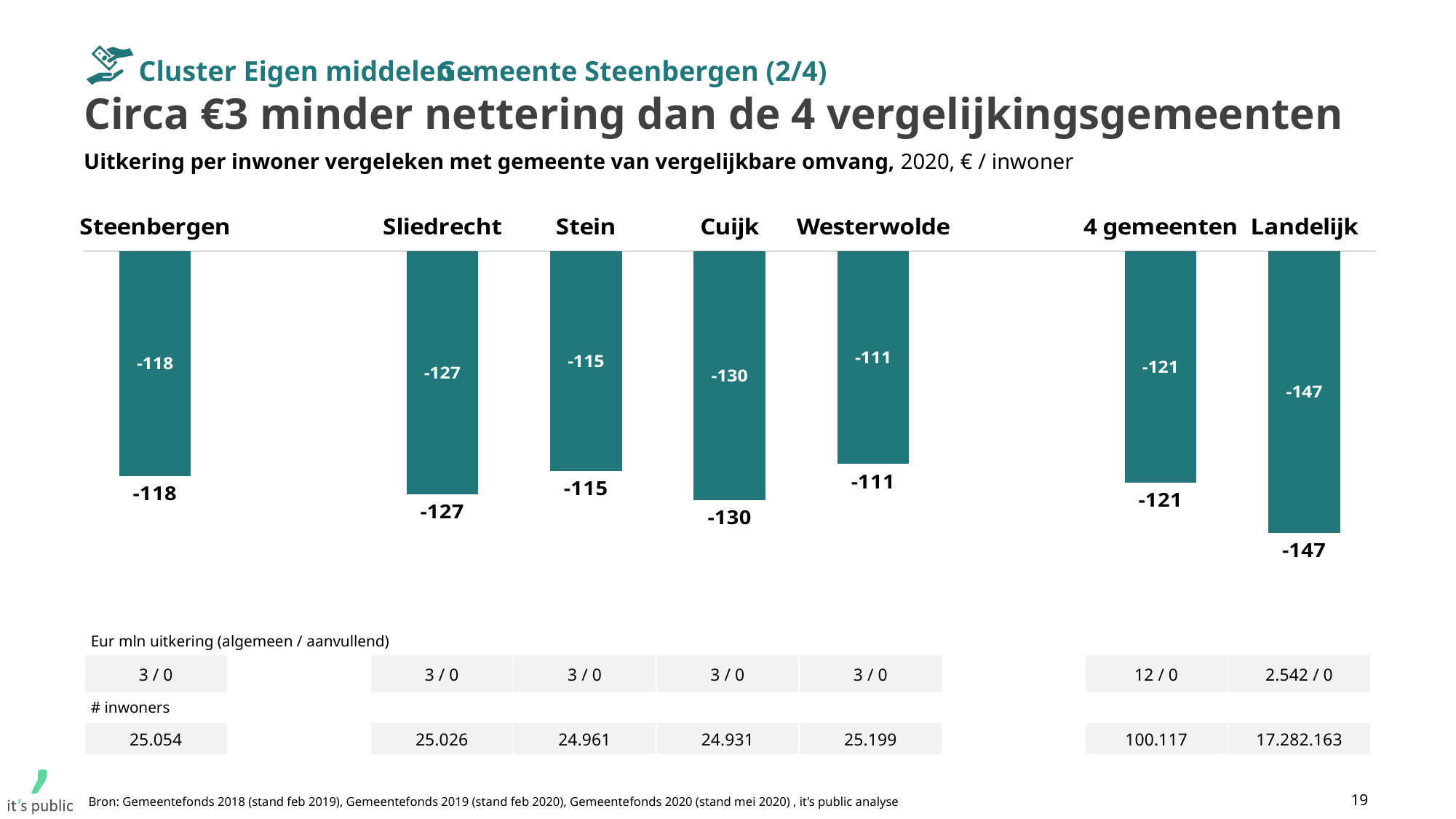
What is the value shown for Cuijk? -130 Which has the more negative value, Sliedrecht or Stein? Sliedrecht What is the value shown for Landelijk? -147 What is the difference between the values for Steenbergen (-118) and 4 gemeenten (-121)? 3 What kind of chart is shown on the slide? Bar chart What is the value shown for Steenbergen? -118 Which category has the longest bar (the most negative value)? Landelijk How many bars are plotted in the chart? 7 What is the difference between the values for Landelijk (-147) and Steenbergen (-118)? 29 What is the value shown for Westerwolde? -111 What unit is stated in the chart subtitle for the values? € / inwoner Which category has the shortest bar (the least negative value)? Westerwolde